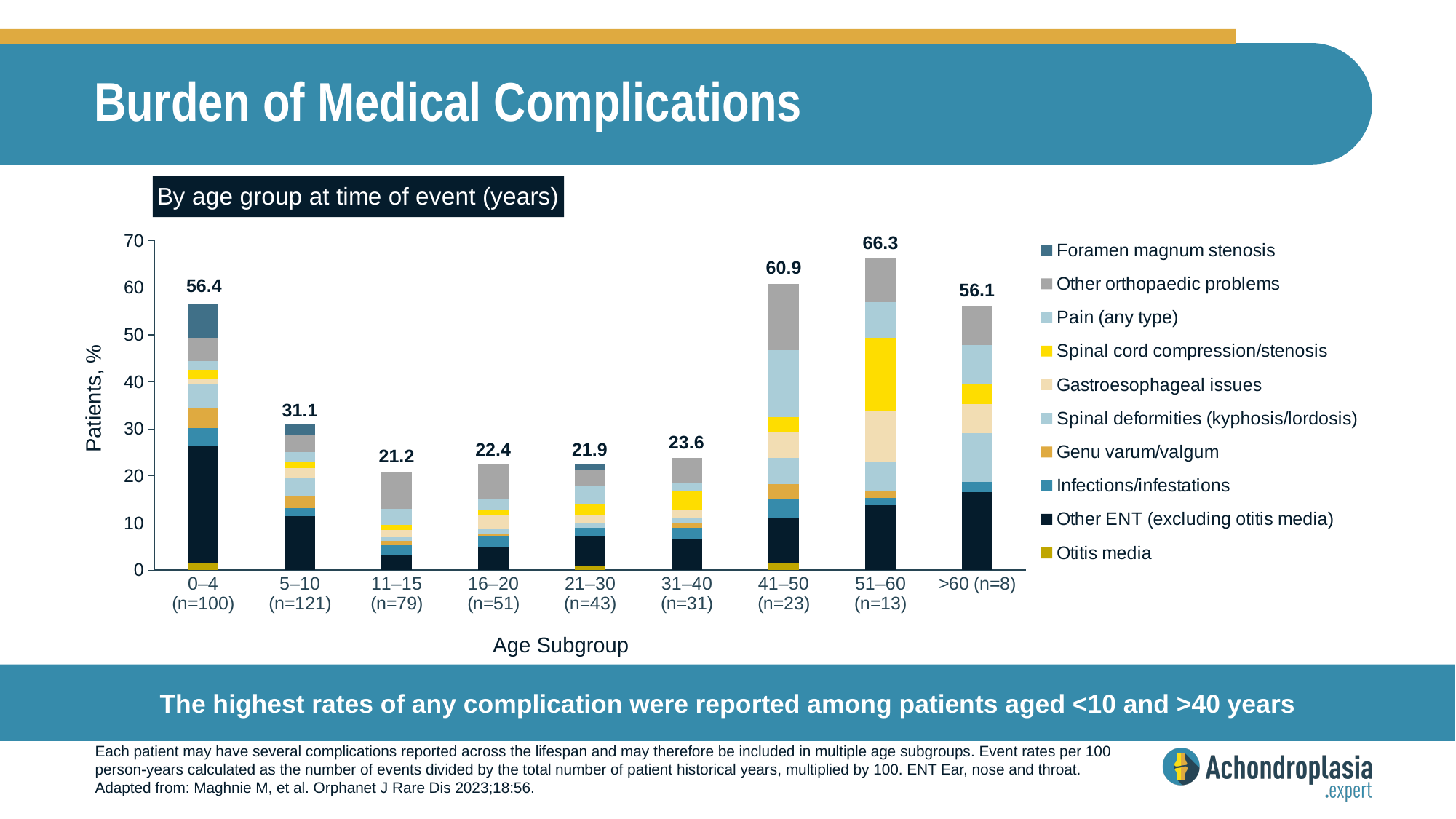
Which age subgroup has the lowest total percentage of patients? 11–15 (n=79) What is the difference between the total for the 51–60 age subgroup and the total for the 0–4 age subgroup? 9.9 How many complication categories does the legend list? 10 What is the total value labelled for the 41–50 (n=23) age subgroup? 60.9 What is the total value labelled for the >60 (n=8) age subgroup? 56.1 What is the total value labelled for the 0–4 (n=100) age subgroup? 56.4 Is the Other ENT (excluding otitis media) value for the 0–4 age subgroup greater or less than 20? greater Which has a larger total: the 16–20 age subgroup or the 31–40 age subgroup? 31–40 (n=31) What is the difference between the total for the 41–50 age subgroup and the total for the 5–10 age subgroup? 29.8 What kind of chart is shown on the slide? Stacked bar chart Which age subgroup has the highest total percentage of patients? 51–60 (n=13) How many age subgroups are shown on the x axis? 9